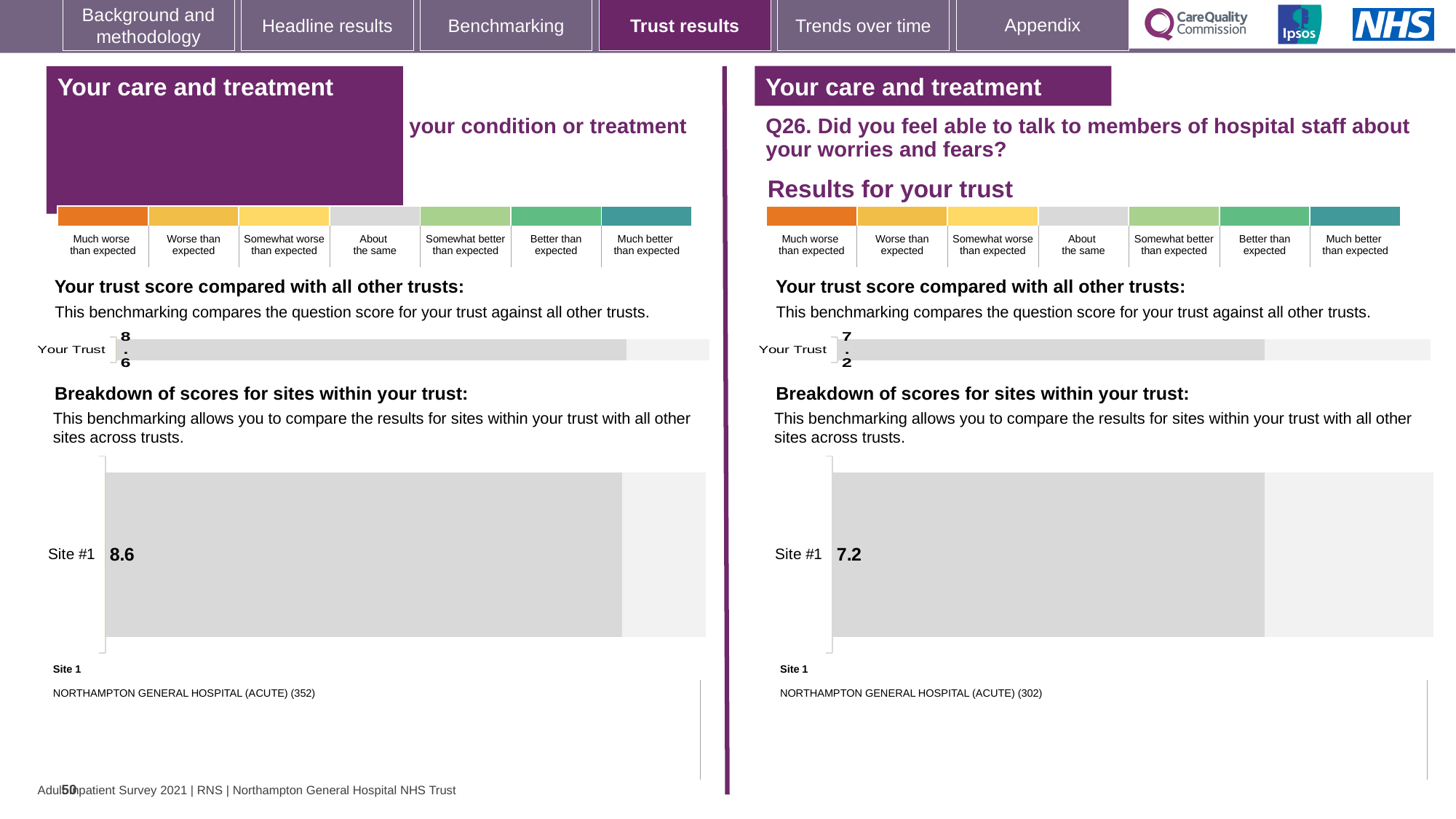
On the right half of the slide (Q26), which site name is listed as Site 1 below the breakdown chart? NORTHAMPTON GENERAL HOSPITAL (ACUTE) (302) On the right half of the slide (Q26), what is the score shown for Your Trust in the 'Your trust score compared with all other trusts' chart? 7.2 What type of chart is used to show the Site #1 score on the right half of the slide (Q26)? Bar chart On the right half of the slide (Q26), what is the score shown for Site #1 in the 'Breakdown of scores for sites within your trust' chart? 7.2 On the left half of the slide, what number appears in brackets after NORTHAMPTON GENERAL HOSPITAL (ACUTE) under Site 1? 352 On the left half of the slide, what is the score shown for Your Trust in the 'Your trust score compared with all other trusts' chart? 8.6 How many sites are shown in the 'Breakdown of scores for sites within your trust' chart on the left half of the slide? 1 Which is larger: the Site #1 score on the left half of the slide or the Site #1 score on the right half (Q26)? Left half (8.6) On the left half of the slide, is the Site #1 score the same as the Your Trust score? Yes What is the difference between the Your Trust score on the left half of the slide and the Your Trust score on the right half (Q26)? 1.4 On the left half of the slide, what is the score shown for Site #1 in the 'Breakdown of scores for sites within your trust' chart? 8.6